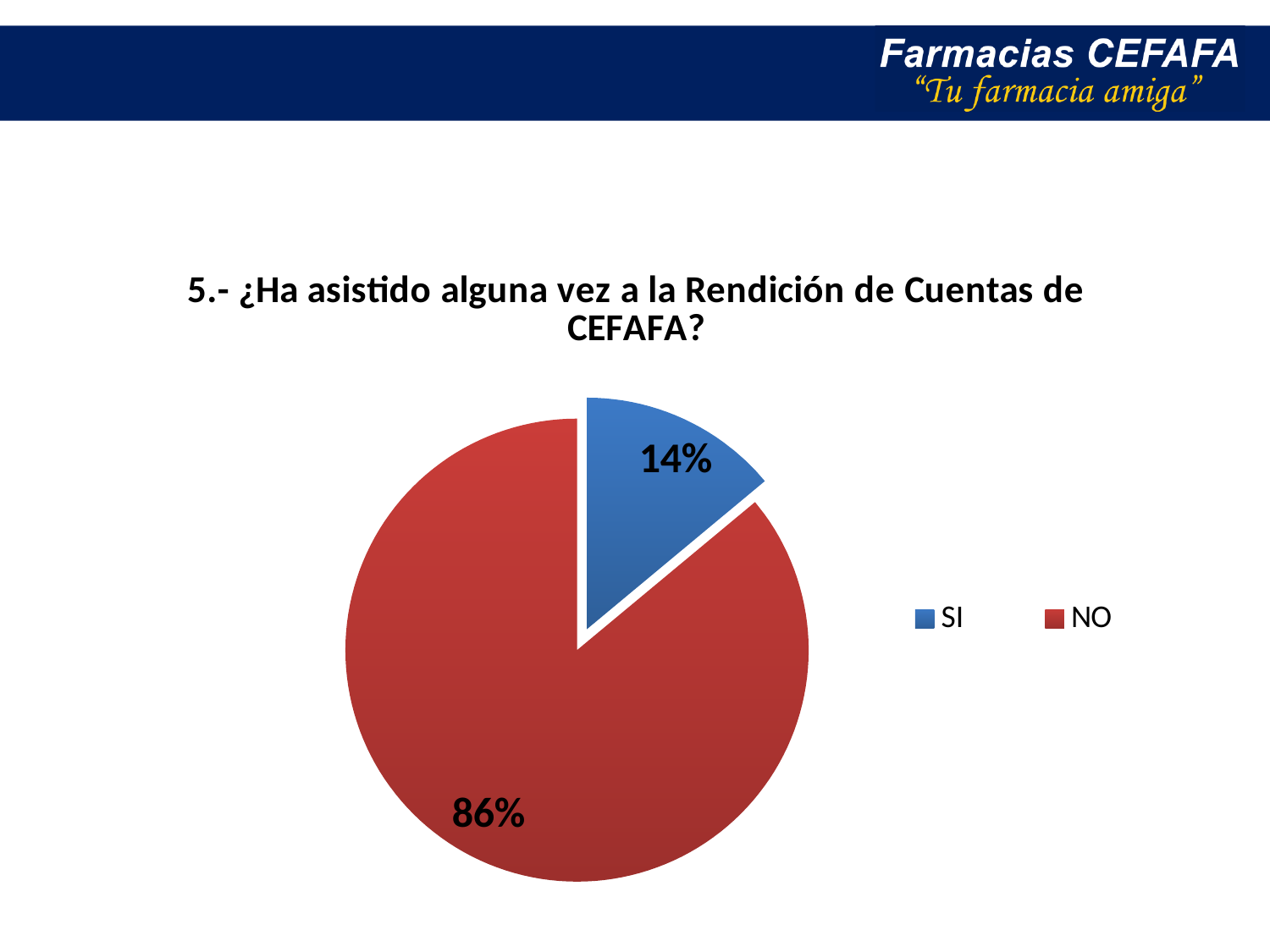
How many slices does the pie chart have? 2 Which category has the largest share of the pie chart? NO What percentage of the pie chart is labelled NO? 86% What is the difference in percentage points between the NO and SI slices? 72 What colour is the NO slice in the pie chart? Red What is the title of the chart? 5.- ¿Ha asistido alguna vez a la Rendición de Cuentas de CEFAFA? What share of the pie does the SI slice represent? 14% How many entries does the legend list? 2 Which category has the smallest share of the pie chart? SI Which slice is larger, SI or NO? NO What percentage of the pie chart is labelled SI? 14% What kind of chart is shown on the slide? Pie chart